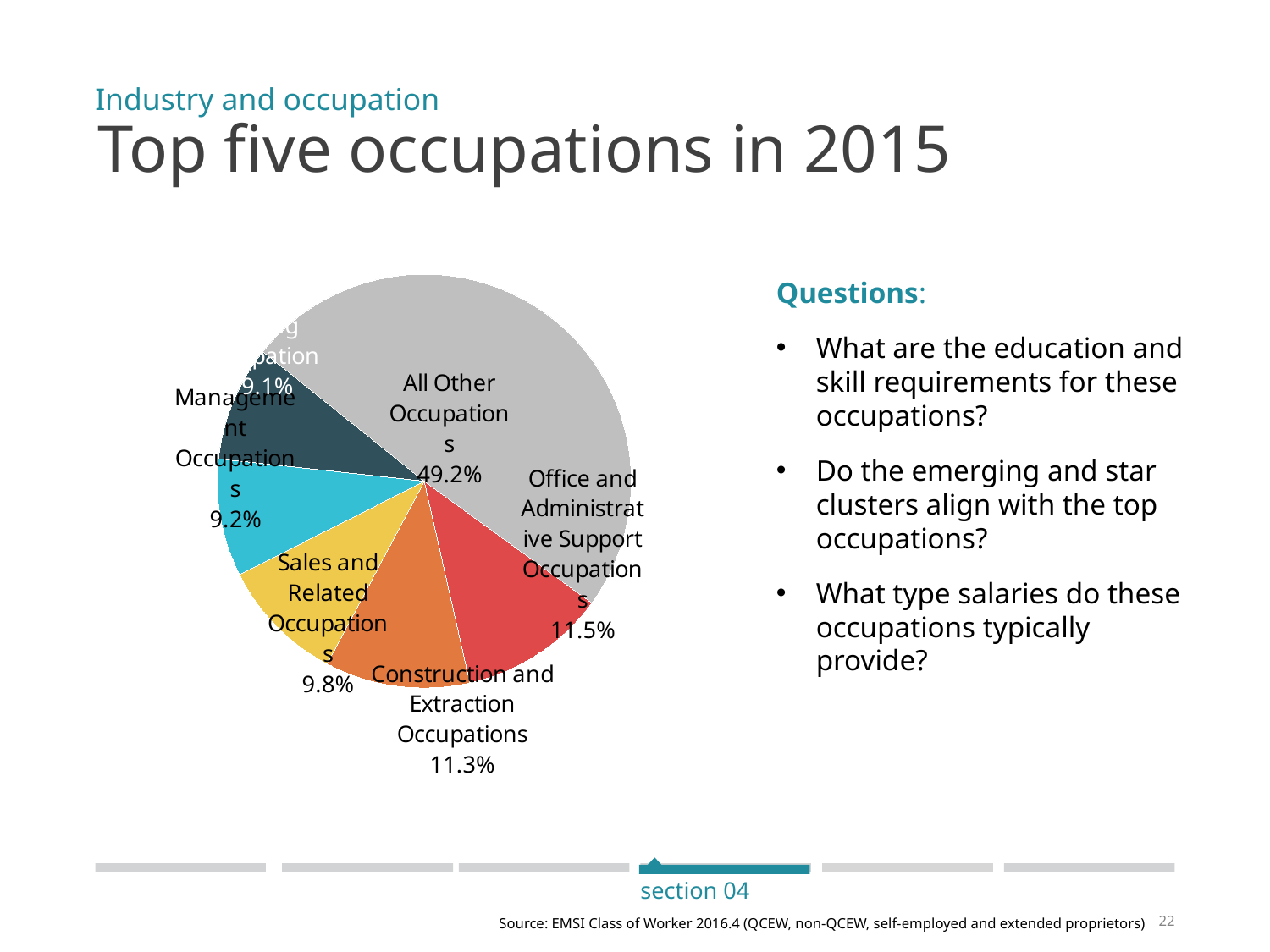
What share of the pie is labelled for All Other Occupations? 49.2% What is the title of the slide containing the pie chart? Top five occupations in 2015 How many slices does the pie chart have? 6 What kind of chart is shown on the slide? pie chart What percentage is shown for Management Occupations? 9.2% What is the difference in percentage points between Office and Administrative Support Occupations and Construction and Extraction Occupations? 0.2% What percentage is shown for Construction and Extraction Occupations? 11.3% What percentage is shown for Office and Administrative Support Occupations? 11.5% What percentage is shown for Sales and Related Occupations? 9.8% Which has the larger share: Sales and Related Occupations or Management Occupations? Sales and Related Occupations Which slice of the pie is the largest? All Other Occupations What is the difference in percentage points between Sales and Related Occupations and Management Occupations? 0.6%